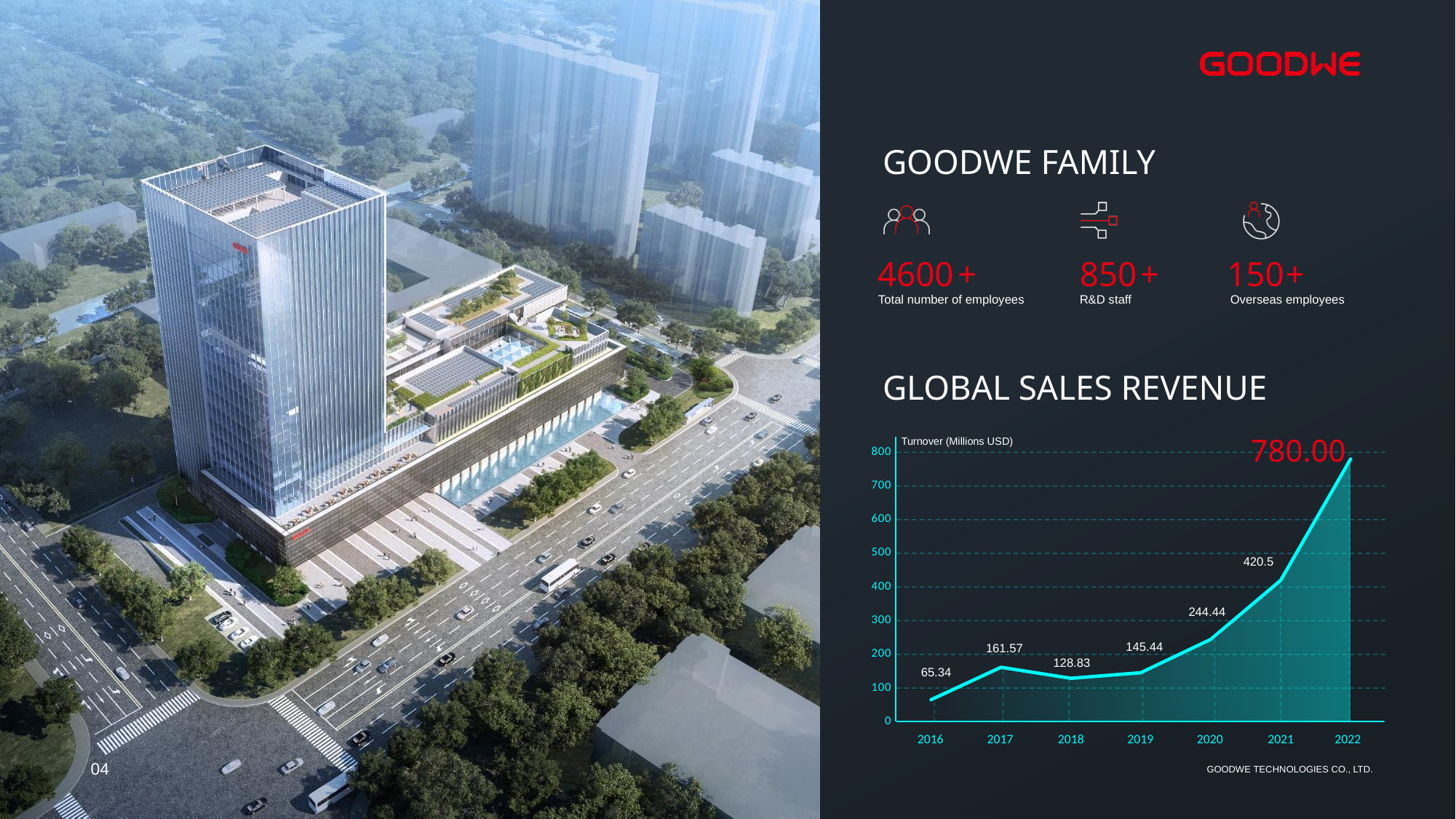
Which year had higher turnover, 2017 or 2018? 2017 How many years are shown on the x axis of the chart? 7 Is the turnover for 2019 greater or less than 200? less What was the turnover in 2022? 780.00 What unit is the turnover measured in, according to the chart's axis label? Millions USD What kind of chart is used to show global sales revenue? line chart What is the difference in turnover between 2021 and 2020? 176.06 Which year had the highest turnover? 2022 What was the turnover in 2018? 128.83 What was the turnover in 2016? 65.34 Which year had the lowest turnover? 2016 What was the turnover in 2020? 244.44